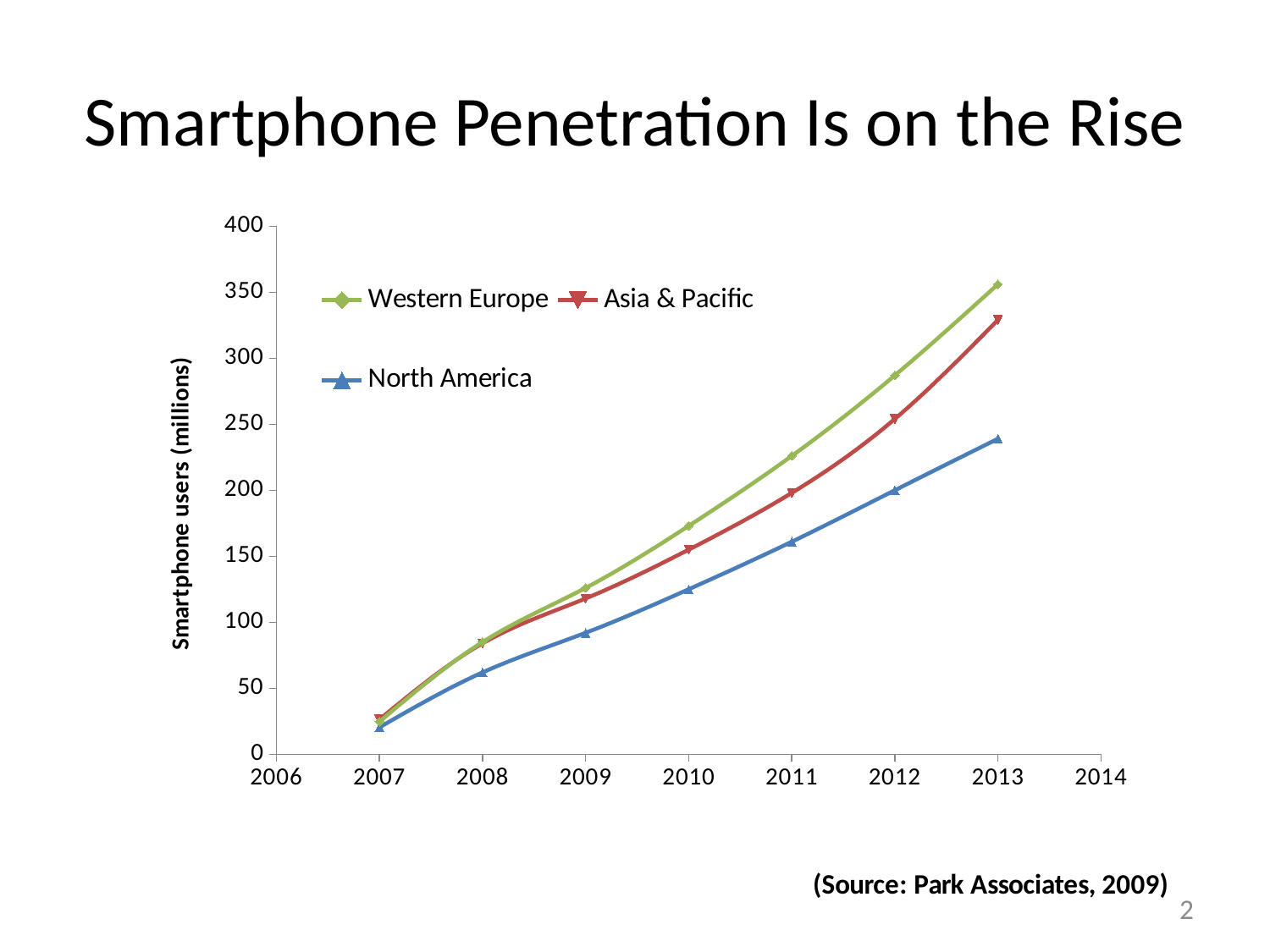
Which series has the lowest value in 2013? North America What kind of chart is shown on the slide? line chart Is the value for Western Europe in 2013 greater or less than 300? greater How many series does the legend list? 3 In 2012, which is larger: Asia & Pacific or North America? Asia & Pacific Is the value for Asia & Pacific in 2009 greater or less than 100? greater Which series has the highest value in 2013? Western Europe Is the value for North America in 2007 greater or less than 50? less How many data points are plotted for the Western Europe series? 7 Do the values for North America rise or fall from 2007 to 2013? rise What is the label of the vertical axis? Smartphone users (millions)